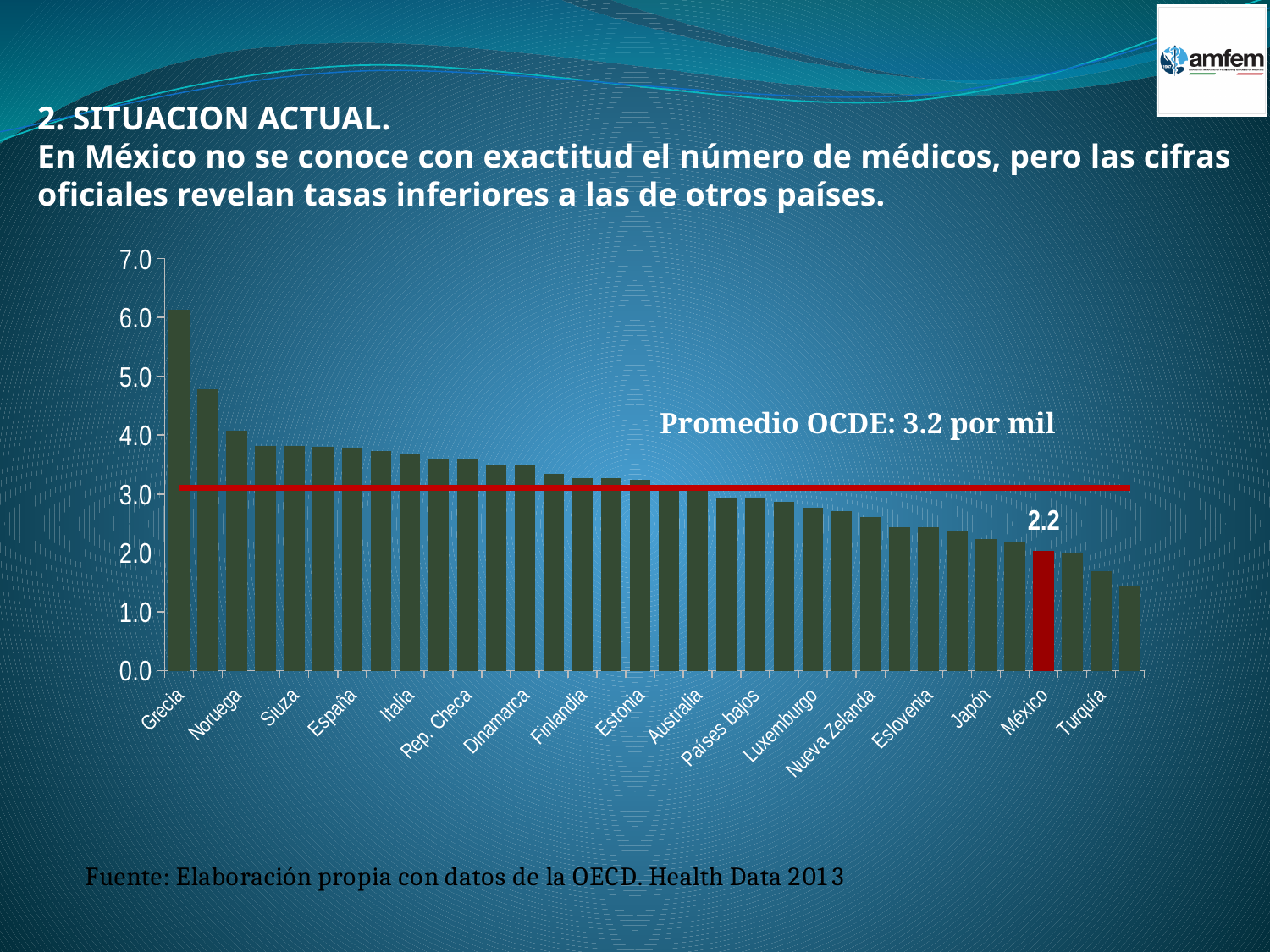
Which has a higher value, Japón or México? Japón Which has a higher value, Grecia or Noruega? Grecia Is the value for Japón greater or less than 3.0? less Do the values rise or fall moving from left to right along the x axis? Fall What OECD average (Promedio OCDE) is stated on the chart? 3.2 por mil Which country has the highest bar in the chart? Grecia What kind of chart is shown on the slide? Bar chart Is the value for Grecia greater or less than 5.0? greater What value is labeled on the bar for México? 2.2 Is the value for Suiza greater or less than 3.0? greater